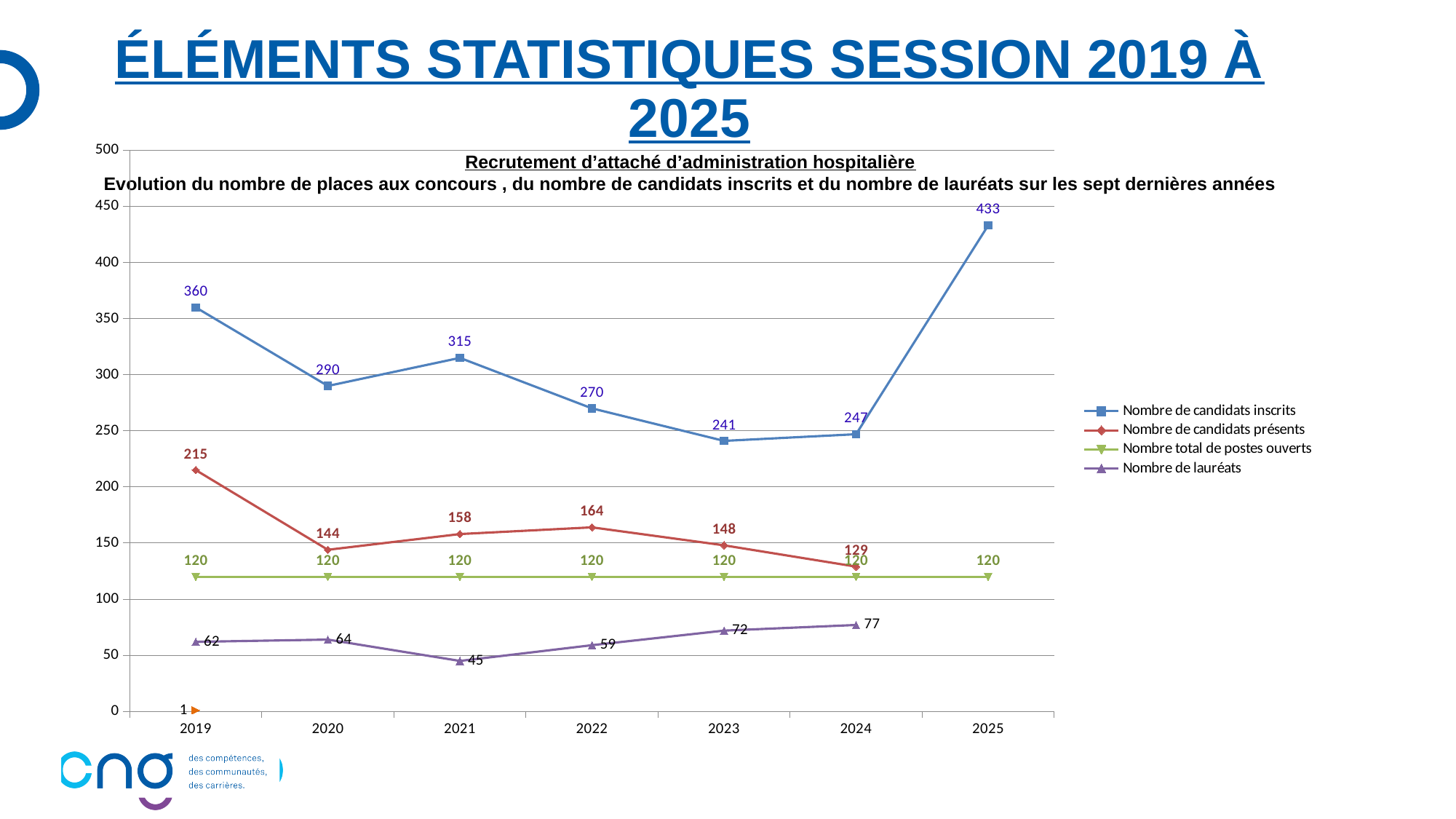
What is the number of candidats inscrits in 2025? 433 What is the number of lauréats in 2021? 45 What is the nombre total de postes ouverts in 2023? 120 What is the number of candidats présents in 2022? 164 In which year is the number of lauréats the highest? 2024 What kind of chart is shown on the slide? Line chart Which is larger: the number of candidats présents in 2021 or in 2023? 2021 How many series does the legend list? 4 In which year is the number of candidats inscrits the lowest? 2023 How many years are shown on the x axis? 7 What is the difference between the number of candidats inscrits in 2025 and in 2024? 186 Does the number of candidats présents rise or fall from 2022 to 2024? Fall